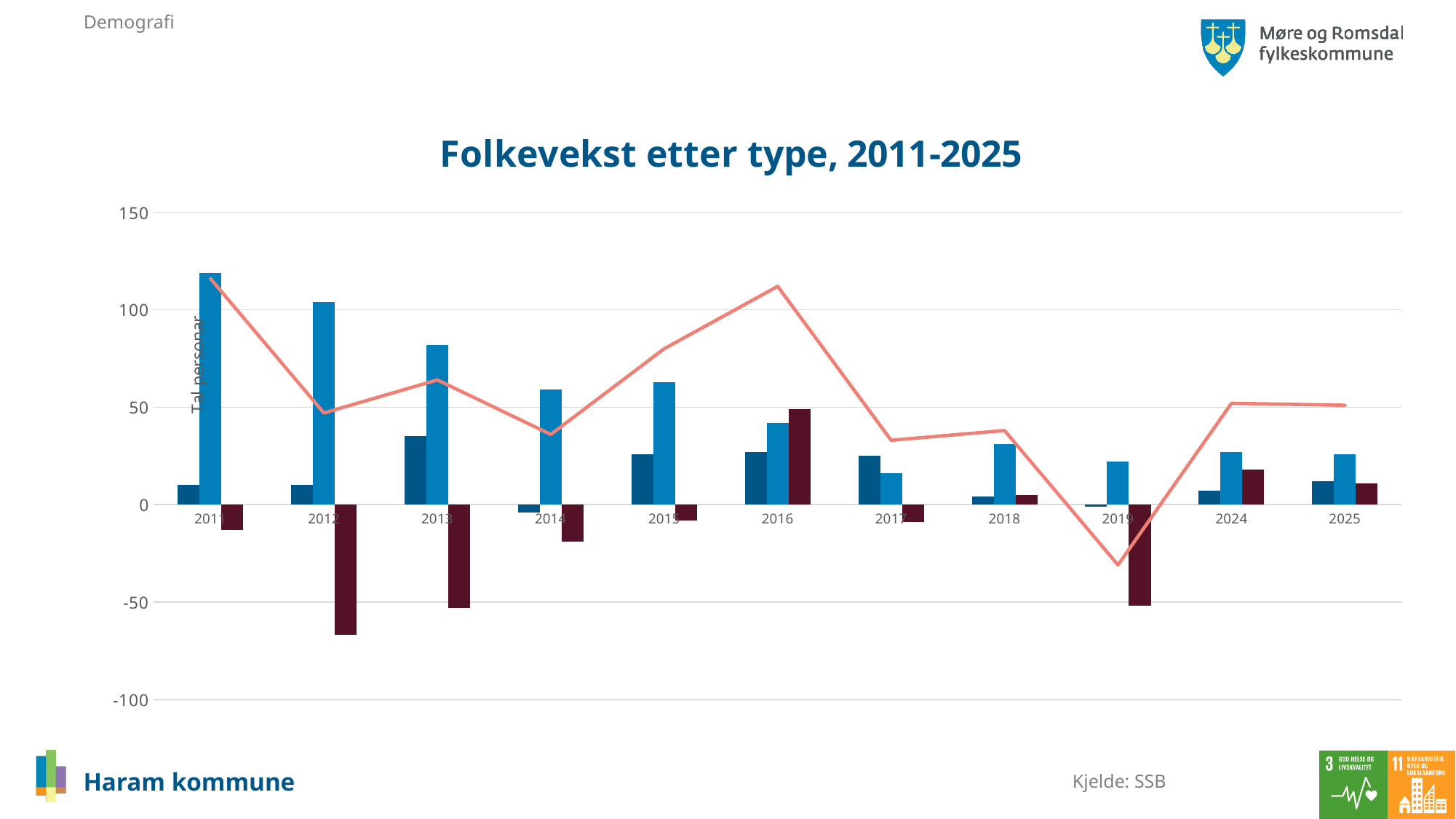
Is the value of the salmon line for 2016 greater or less than 100? greater In which year does the dark red bar reach its lowest value? 2012 In which year is the light blue bar the tallest? 2011 What is the title of the chart? Folkevekst etter type, 2011-2025 In which year does the salmon line reach its highest point? 2016 Is the value of the light blue bar for 2011 greater or less than 100? greater In which year does the salmon line reach its lowest point? 2019 Which year has the larger light blue bar, 2011 or 2012? 2011 Is the value of the dark red bar for 2012 greater or less than -50? less How many years are shown on the x axis of the chart? 11 What kind of chart is shown on the slide? Bar chart with a line What is the label on the vertical axis of the chart? Tal personar